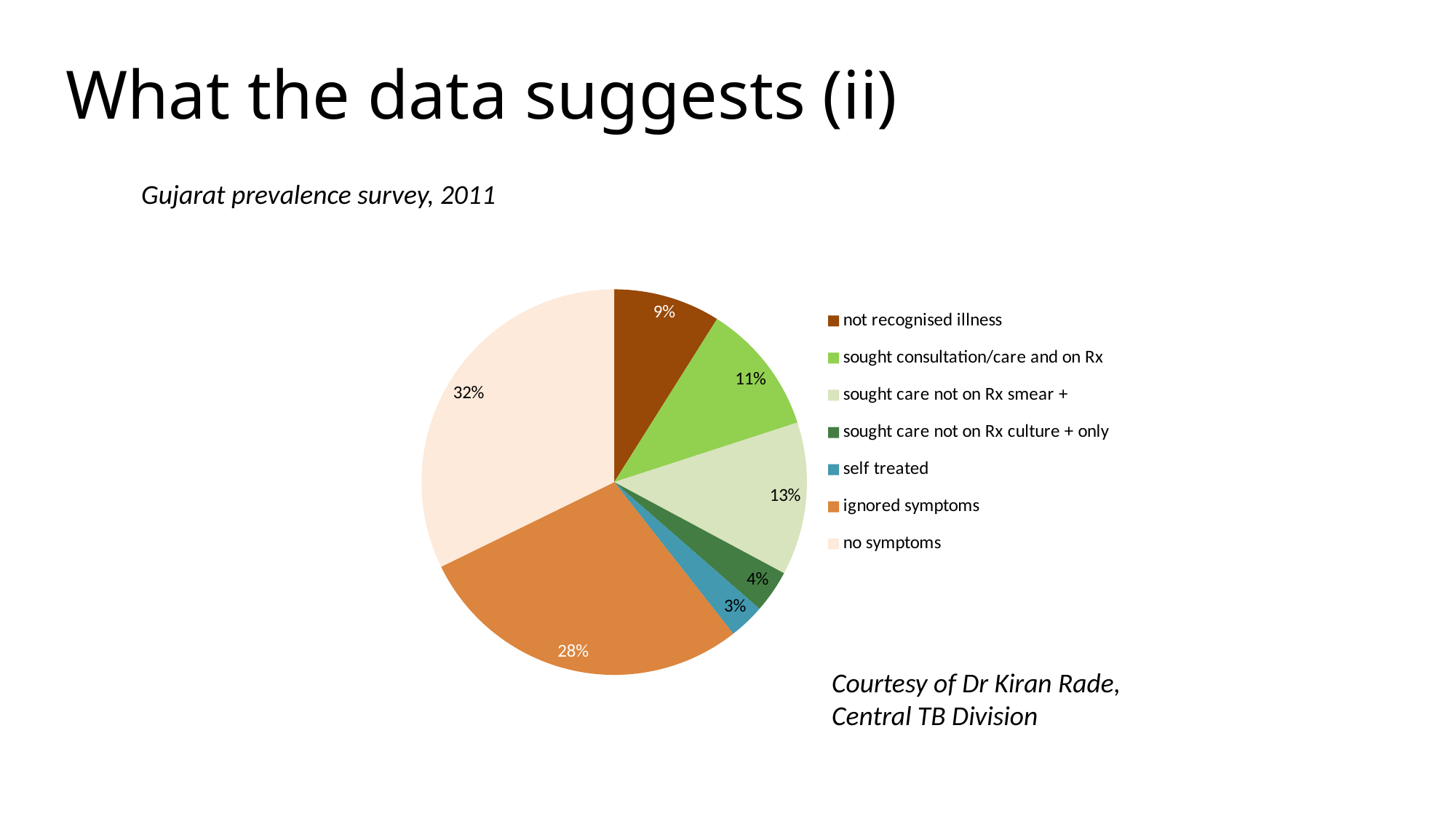
What percentage of the pie is 'ignored symptoms'? 28% What kind of chart is shown on the slide? pie chart What percentage of the pie is 'self treated'? 3% Which category has the smallest share of the pie? self treated What percentage of the pie is 'not recognised illness'? 9% What percentage of the pie is 'no symptoms'? 32% Which is larger: 'sought consultation/care and on Rx' or 'sought care not on Rx smear +'? sought care not on Rx smear + What is the subtitle above the pie chart? Gujarat prevalence survey, 2011 Which category has the largest share of the pie? no symptoms What percentage of the pie is 'sought care not on Rx smear +'? 13% What is the difference in percentage points between 'no symptoms' and 'ignored symptoms'? 4 How many categories does the legend list? 7